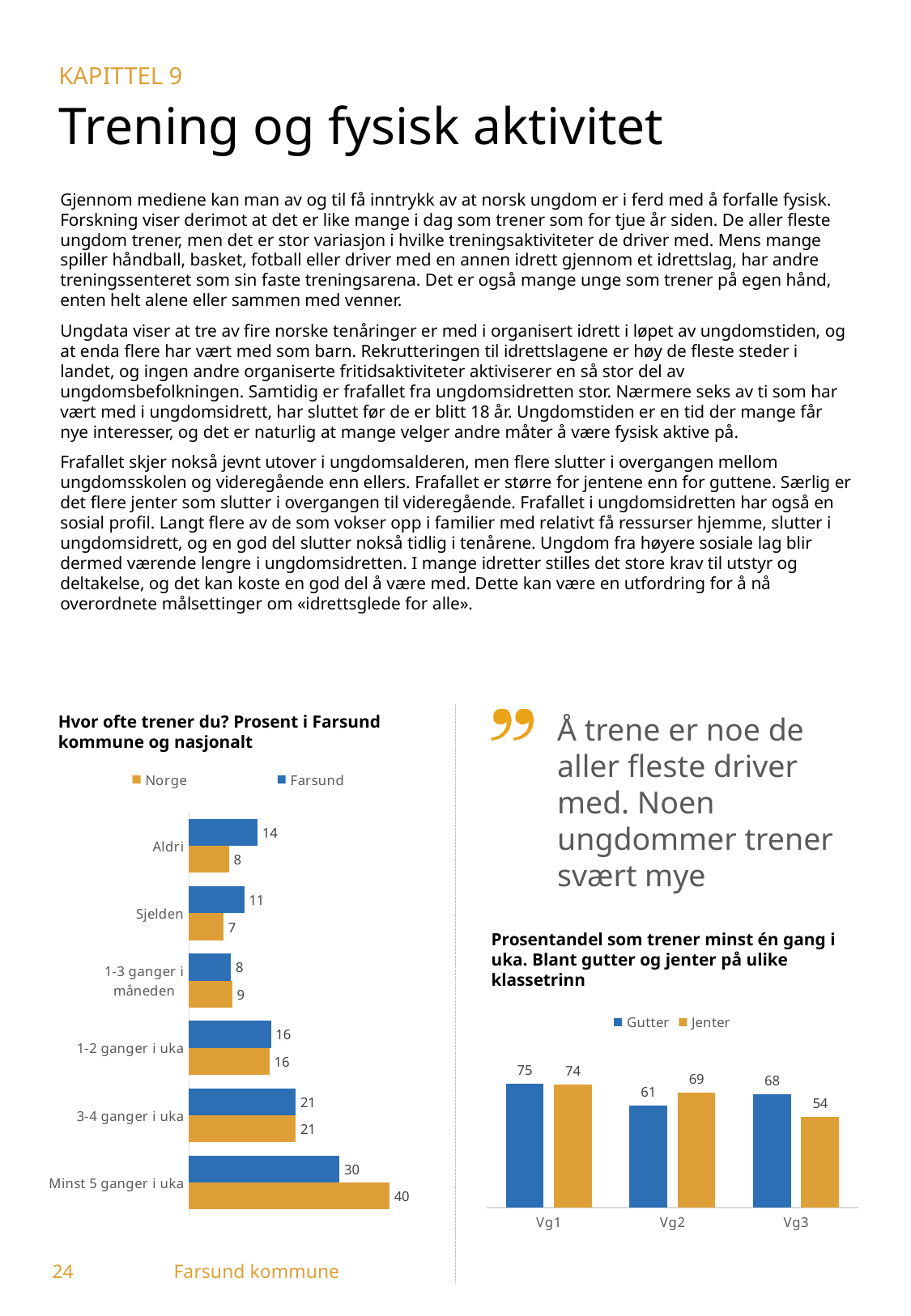
What type of chart is 'Hvor ofte trener du? Prosent i Farsund kommune og nasjonalt'? Bar chart In the chart 'Hvor ofte trener du? Prosent i Farsund kommune og nasjonalt', which is larger for 'Sjelden': Farsund or Norge? Farsund In the chart 'Prosentandel som trener minst én gang i uka', what is the difference between Gutter and Jenter at Vg3? 14 In the chart 'Hvor ofte trener du? Prosent i Farsund kommune og nasjonalt', what is the value for Farsund in the category 'Minst 5 ganger i uka'? 30 In the chart 'Hvor ofte trener du? Prosent i Farsund kommune og nasjonalt', what is the difference between Norge and Farsund for 'Minst 5 ganger i uka'? 10 In the chart 'Prosentandel som trener minst én gang i uka', which colour represents Gutter? Blue How many categories are shown in the chart 'Hvor ofte trener du? Prosent i Farsund kommune og nasjonalt'? 6 In the chart 'Prosentandel som trener minst én gang i uka', which class level has the lowest value for Jenter? Vg3 In the chart 'Hvor ofte trener du? Prosent i Farsund kommune og nasjonalt', what is the value for Norge in the category 'Aldri'? 8 How many series does the legend list in the chart 'Prosentandel som trener minst én gang i uka'? 2 In the chart 'Prosentandel som trener minst én gang i uka', what is the value for Jenter at Vg2? 69 In the chart 'Hvor ofte trener du? Prosent i Farsund kommune og nasjonalt', which category has the highest value for Norge? Minst 5 ganger i uka